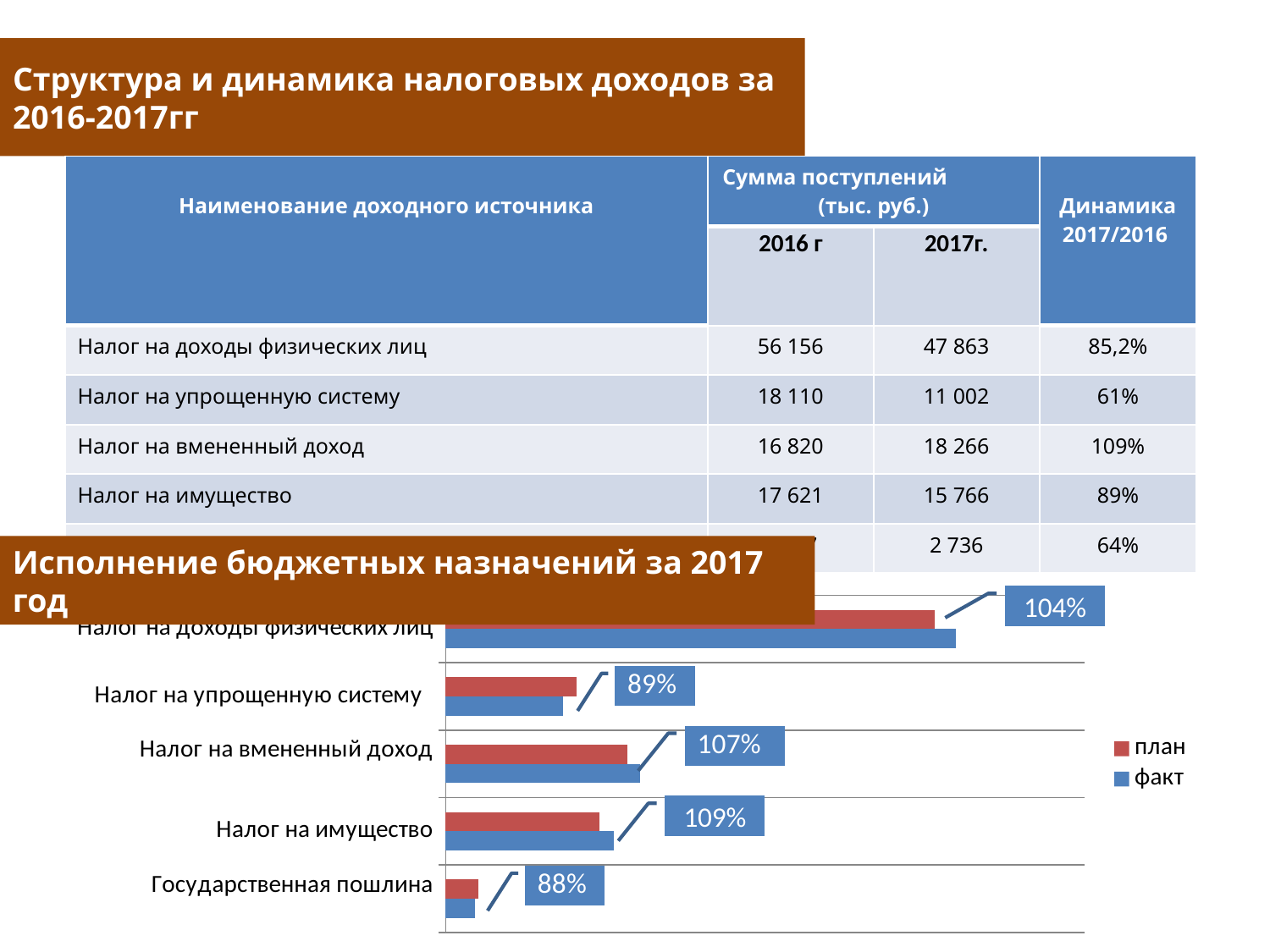
In the bar chart, what percentage is shown for Государственная пошлина? 88% How many categories are shown in the bar chart? 5 In the bar chart, which category has the highest percentage label? Налог на имущество In the bar chart, what percentage is shown for Налог на упрощенную систему? 89% In the bar chart, what percentage is shown for Налог на доходы физических лиц? 104% In the bar chart, which colour represents the факт series? blue In the bar chart, what percentage is shown for Налог на вмененный доход? 107% In the bar chart, which category has the longest факт bar? Налог на доходы физических лиц What kind of chart is shown at the bottom of the slide? bar chart How many series does the legend of the bar chart list? 2 What are the two series named in the legend of the bar chart? план, факт In the bar chart, for Налог на упрощенную систему, which bar is longer: план or факт? план